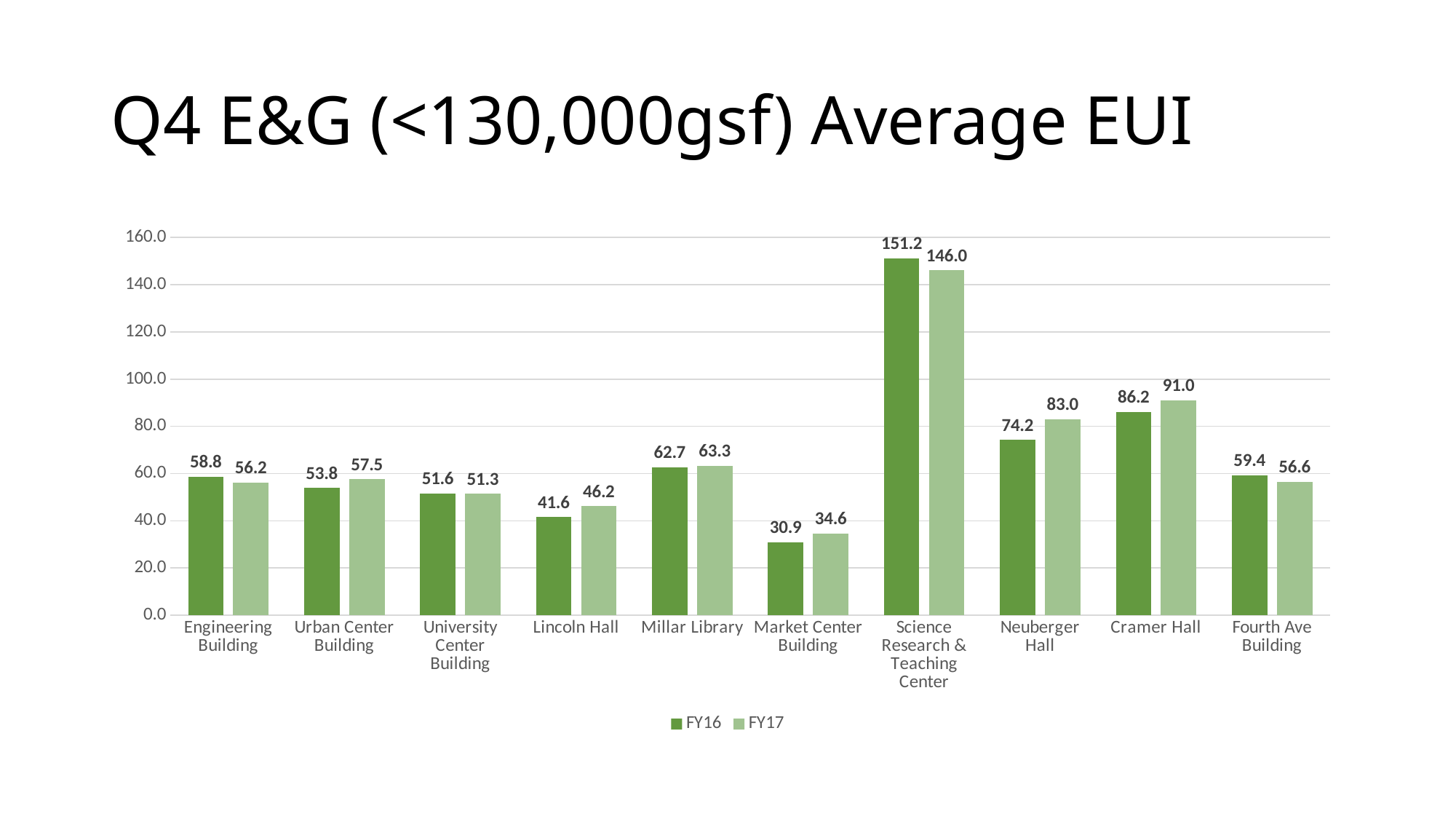
Which building has the lowest FY17 value? Market Center Building What is the difference between the FY17 and FY16 values for Cramer Hall? 4.8 Which building has the highest FY16 value? Science Research & Teaching Center What kind of chart is shown on the slide? bar chart Which is larger for the Engineering Building, the FY16 value or the FY17 value? FY16 How many buildings are shown on the x axis? 10 What is the FY17 value for the Science Research & Teaching Center? 146.0 What is the title of the chart? Q4 E&G (<130,000gsf) Average EUI Is the FY16 value for Neuberger Hall greater or less than 80.0? less What is the FY16 value for Lincoln Hall? 41.6 How many series does the legend list? 2 What is the FY17 value for Neuberger Hall? 83.0